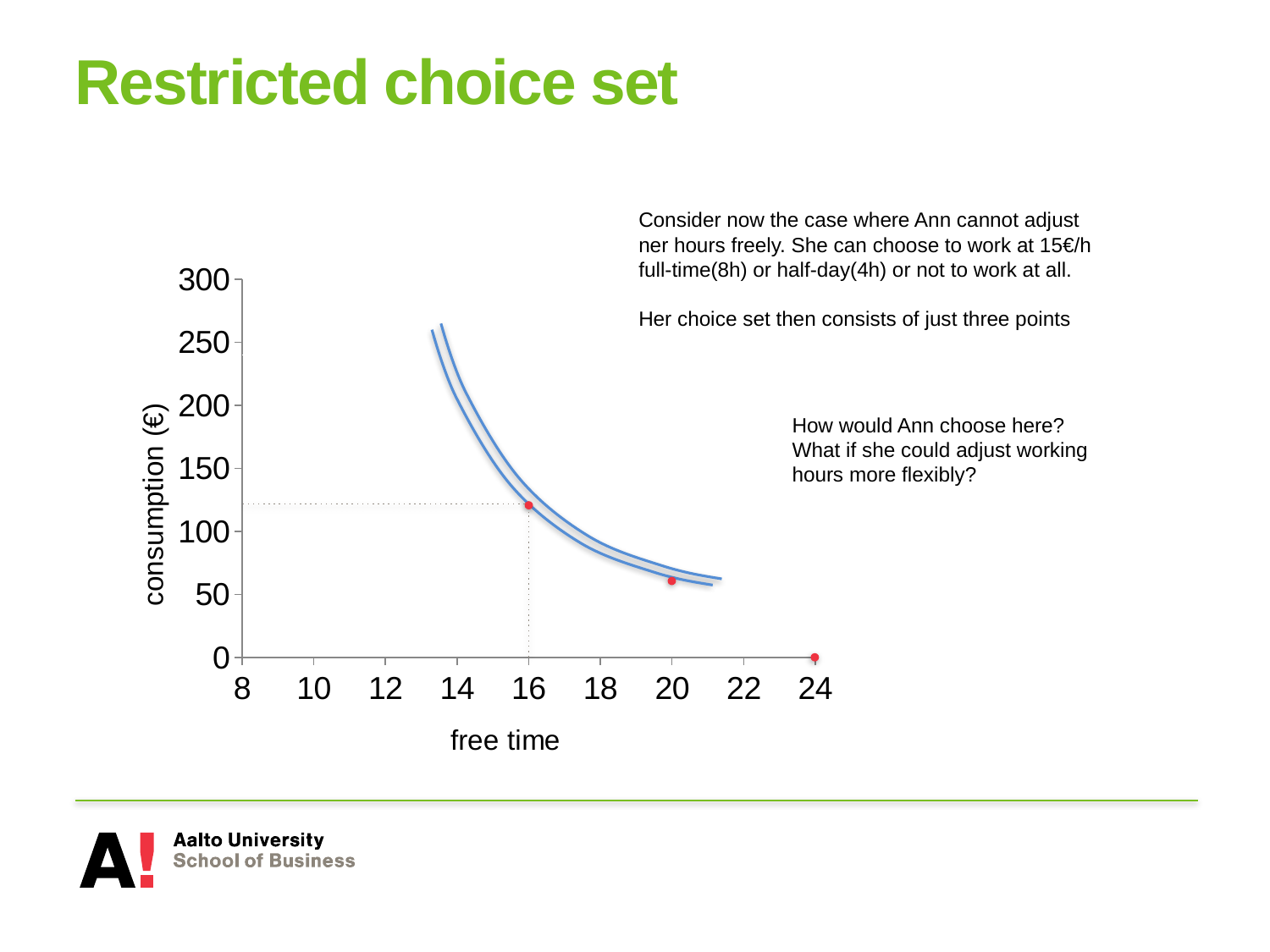
What is the label of the vertical axis? consumption (€) Is the consumption value of the point at 20 hours of free time greater or less than 100? less Which plotted point has higher consumption: the one at 16 hours of free time or the one at 20 hours of free time? 16 hours of free time What is the label of the horizontal axis? free time At which free time value does the plotted point have the lowest consumption? 24 Is the consumption value of the point at 16 hours of free time greater or less than 100? greater What is the consumption value of the point plotted at 24 hours of free time? 0 At which free time value does the plotted point have the highest consumption? 16 How many red data points are plotted on the chart? 3 As free time increases along the x axis, does consumption at the plotted points rise or fall? fall Is the consumption value of the point at 16 hours of free time greater or less than 150? less